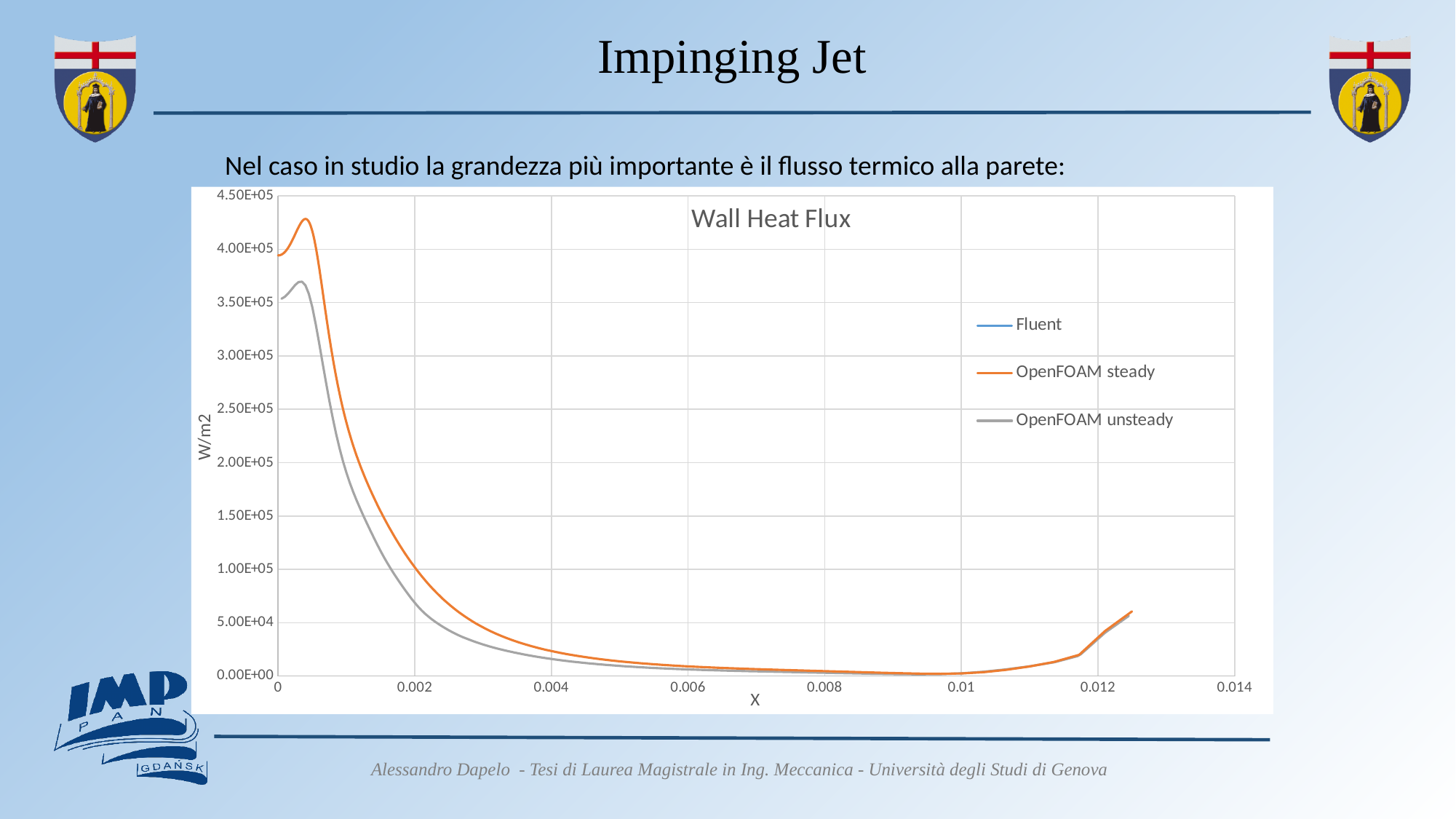
What is the title of the chart? Wall Heat Flux What is the label of the vertical axis of the chart? W/m2 Is the peak value of the OpenFOAM unsteady series greater or less than 4.00E+05? less Between X = 0.001 and X = 0.01, do the wall heat flux values rise or fall along the x axis? fall How many series does the legend of the Wall Heat Flux chart list? 3 Which series reaches the highest peak value on the chart? OpenFOAM steady Near X = 0, which series has the higher wall heat flux, OpenFOAM steady or OpenFOAM unsteady? OpenFOAM steady Is the value of the OpenFOAM steady series at X = 0.004 greater or less than 5.00E+04? less Is the peak value of the OpenFOAM steady series greater or less than 4.00E+05? greater What kind of chart is shown on the slide? line chart